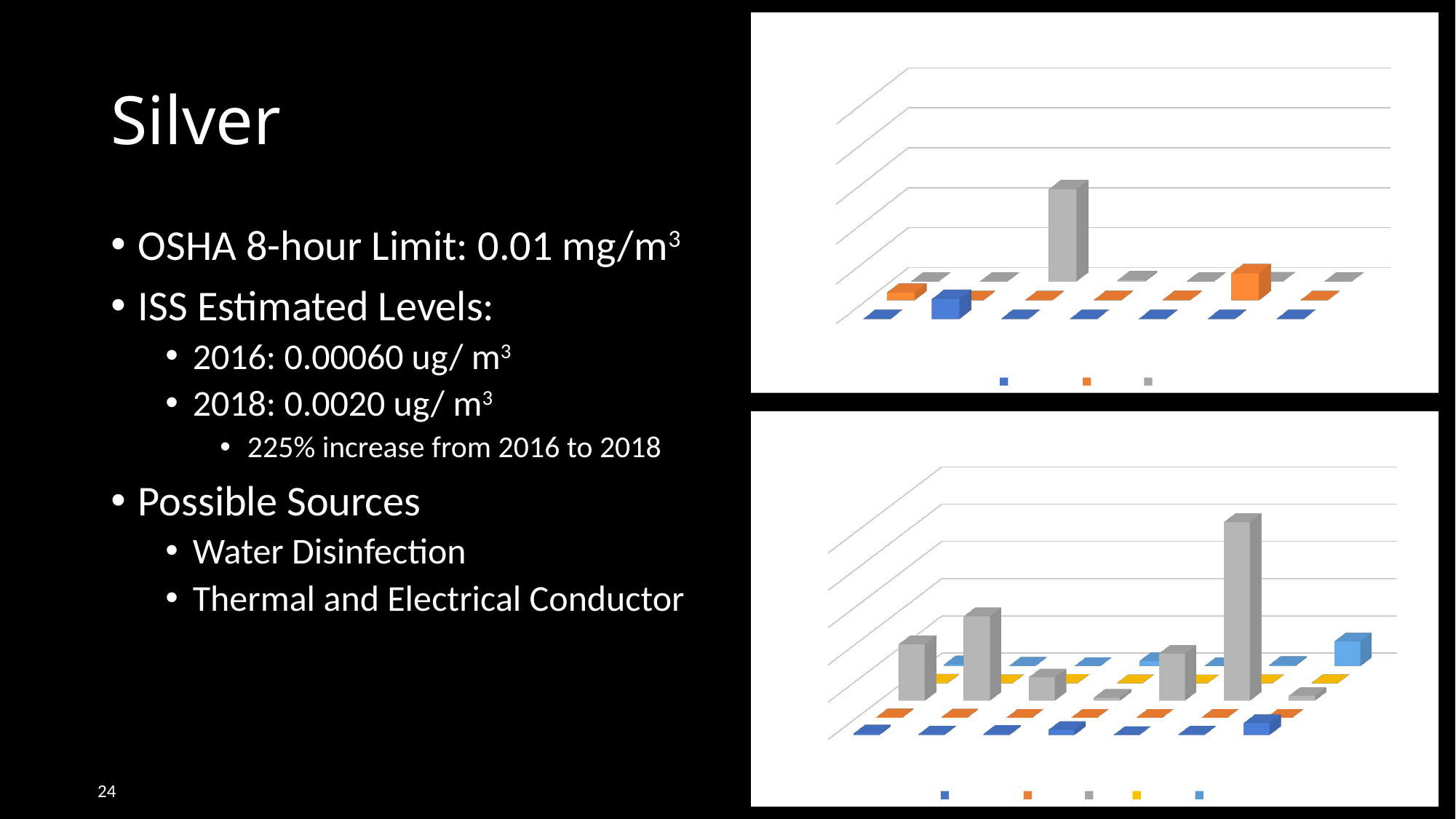
In the bottom chart, what colour is the tallest bar? gray How many series does the legend of the top chart list? 3 What colours are the legend markers in the top chart? blue, orange, gray Does the bottom chart include a yellow series? yes What kind of chart is the top chart on the slide? bar chart How many series does the legend of the bottom chart list? 5 In the bottom chart, which series has more tall bars, the gray series or the orange series? gray In the top chart, what colour is the tallest bar? gray What kind of chart is the bottom chart on the slide? bar chart In the top chart, is the tallest gray bar taller than the tallest orange bar? yes